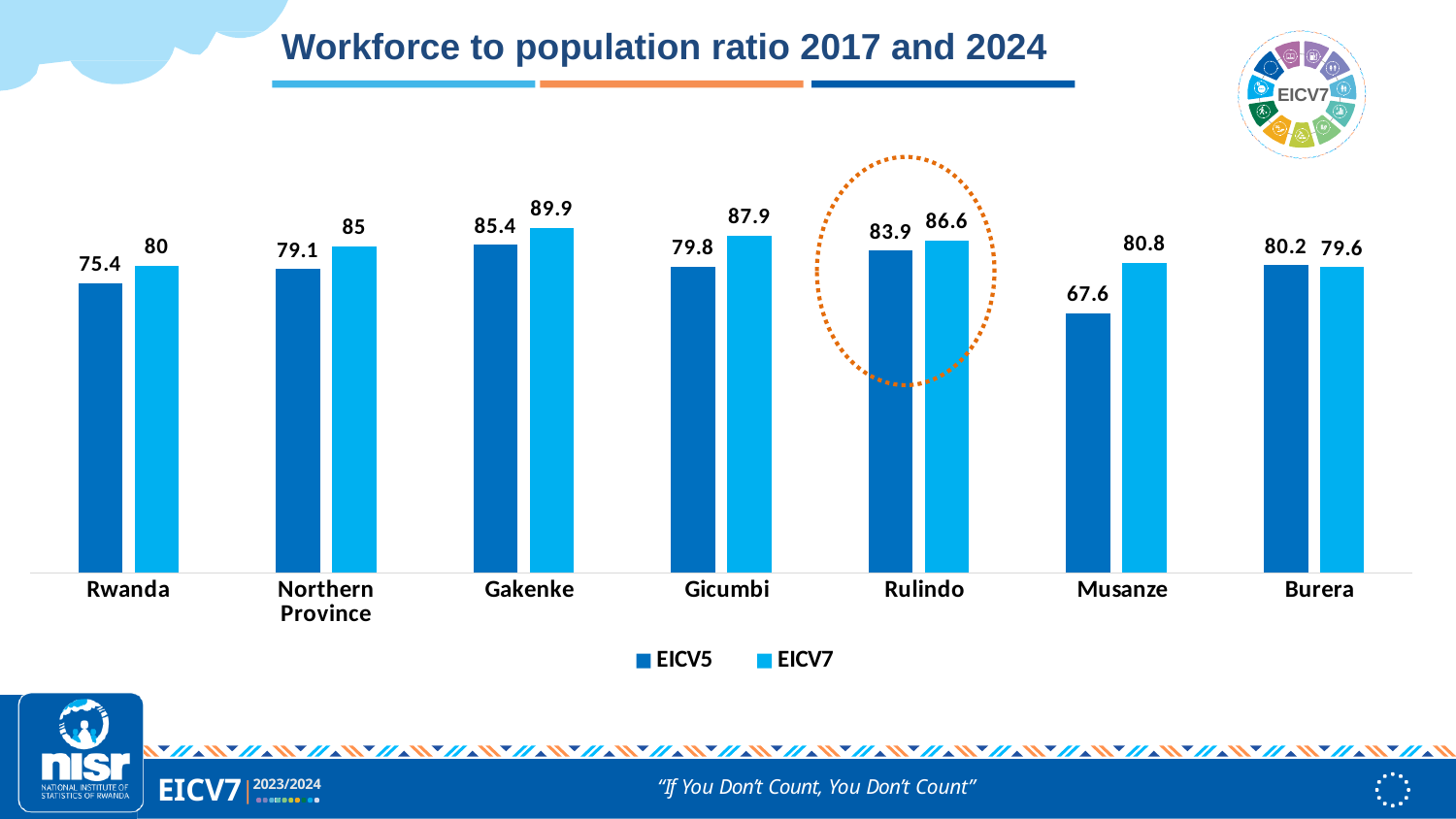
What is the difference between the EICV7 and EICV5 values for Gicumbi? 8.1 For Burera, which is larger, the EICV5 value or the EICV7 value? EICV5 What is the difference between the EICV7 and EICV5 values for Musanze? 13.2 Which category has the lowest EICV5 value? Musanze What kind of chart is shown on the slide? Bar chart What is the EICV5 value for Rwanda? 75.4 Which category has the highest EICV7 value? Gakenke How many series does the legend list? 2 How many categories are shown on the x axis? 7 What is the EICV7 value for Rulindo? 86.6 Which category is highlighted with a dotted orange circle? Rulindo What is the EICV5 value for Musanze? 67.6